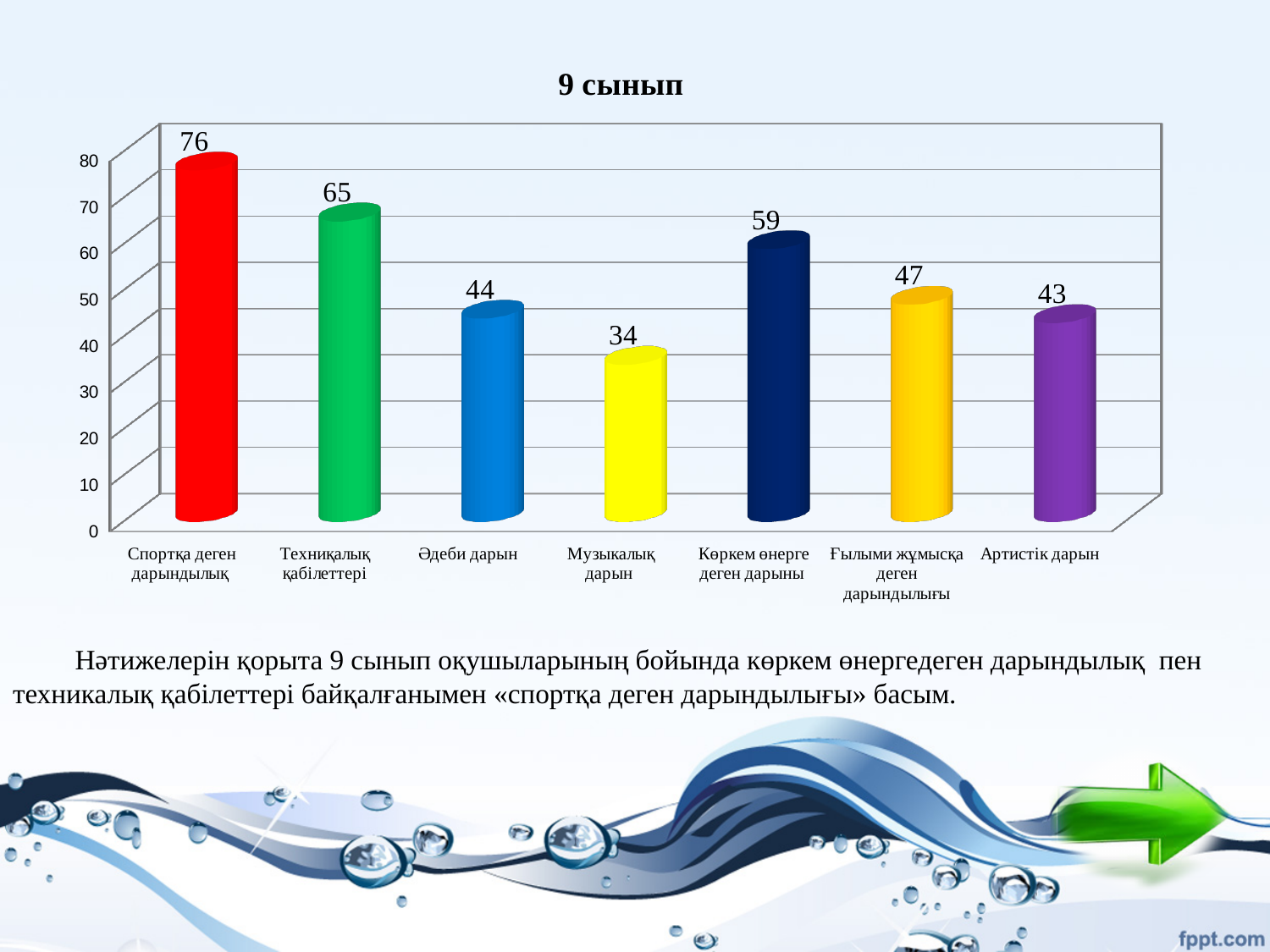
What is the value for Спортқа деген дарындылық? 76 What is the value for Музыкалық дарын? 34 What kind of chart is shown on the slide? bar chart What is the difference between the values for Көркем өнерге деген дарыны and Артистік дарын? 16 Is the value for Көркем өнерге деген дарыны greater or less than 50? greater What is the title of the chart? 9 сынып Which is larger, the value for Әдеби дарын or the value for Артистік дарын? Әдеби дарын How many categories are shown in the chart? 7 Which category has the highest value? Спортқа деген дарындылық Which category has the lowest value? Музыкалық дарын What is the difference between the values for Спортқа деген дарындылық and Техникалық қабілеттері? 11 What is the value for Ғылыми жұмысқа деген дарындылығы? 47